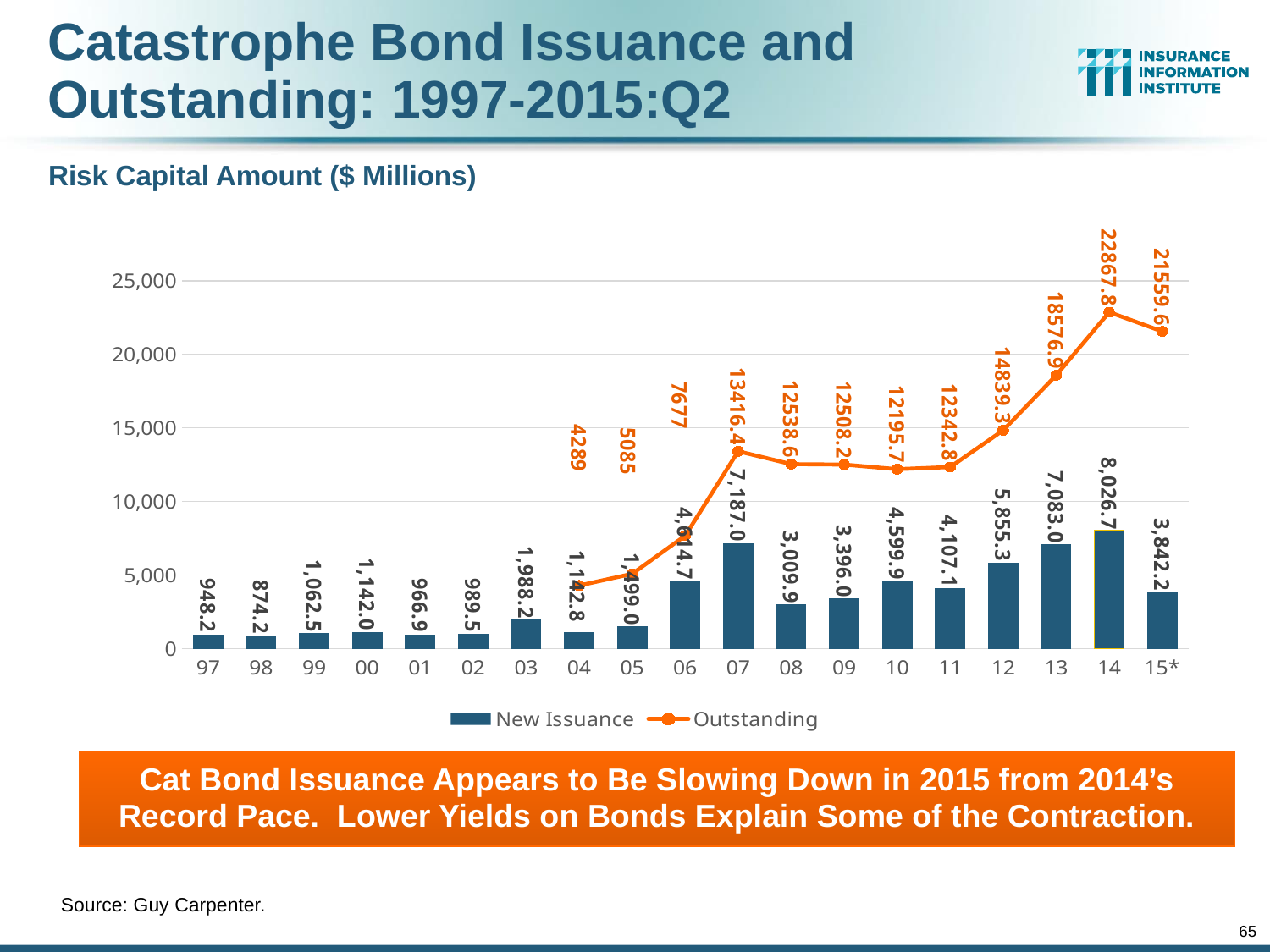
Which year has the highest New Issuance value? 14 What is the New Issuance value for 14? 8,026.7 What is the Outstanding value for 13? 18576.9 Which is larger, the New Issuance value for 07 or for 13? 07 How many years are shown on the x axis? 19 How many series does the legend list? 2 What is the Outstanding value for 04? 4289 What is the difference between the New Issuance values for 14 and 15*? 4,184.5 Is the Outstanding value for 14 greater or less than 20,000? greater Does the Outstanding series rise or fall from 11 to 14? rise Which year has the highest Outstanding value? 14 Which year has the lowest New Issuance value? 98